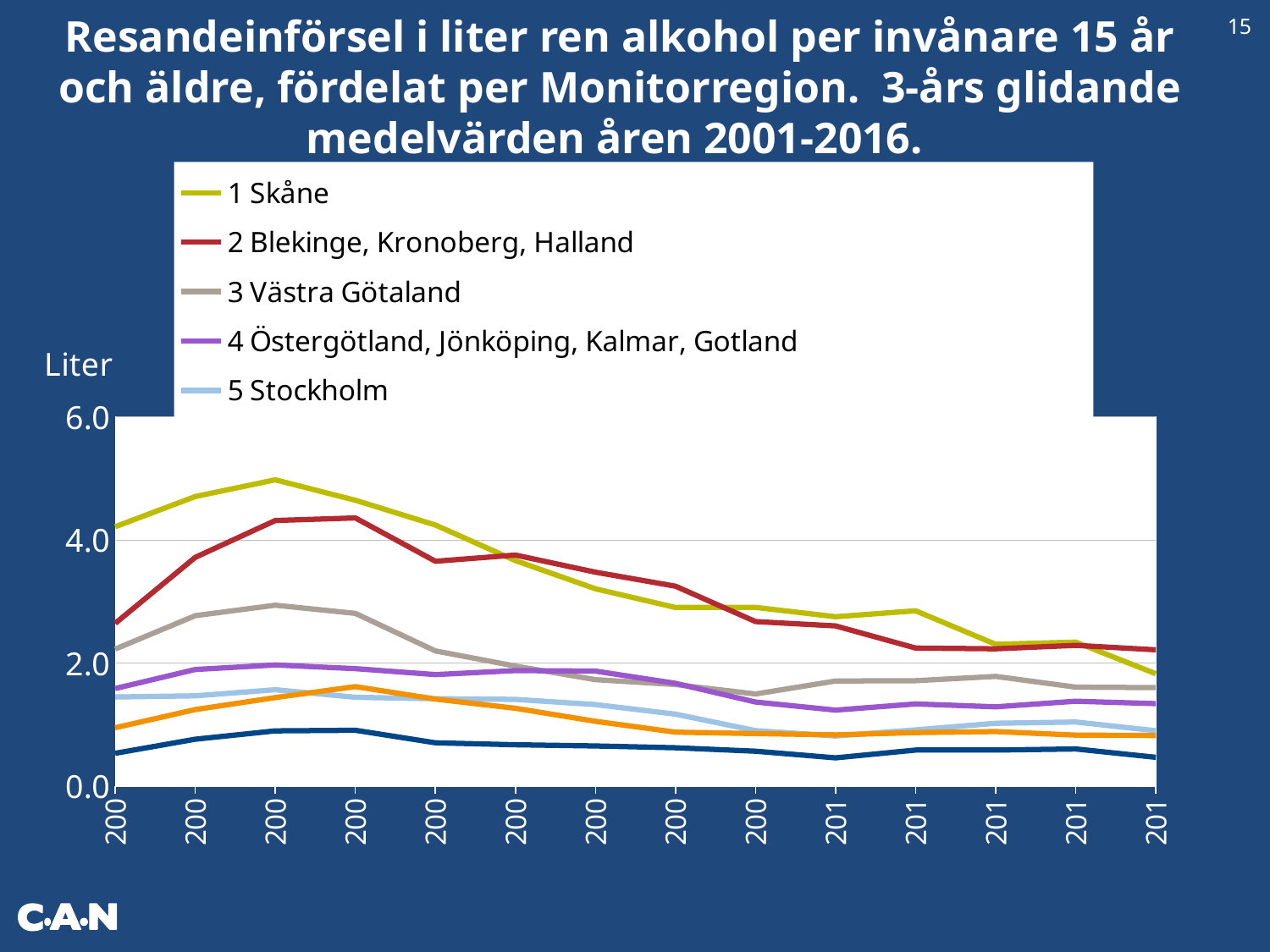
At the first point on the x axis, which is higher: 1 Skåne or 2 Blekinge, Kronoberg, Halland? 1 Skåne Is the highest value of the 5 Stockholm line greater or less than 2.0? less At the last point on the x axis, which is higher: 1 Skåne or 2 Blekinge, Kronoberg, Halland? 2 Blekinge, Kronoberg, Halland Is the highest value of the 1 Skåne line greater or less than 4.0? greater What is the label on the y axis? Liter Which series reaches the highest value anywhere on the chart? 1 Skåne Is the highest value of the 3 Västra Götaland line greater or less than 2.0? greater At the last point on the x axis, which is higher: 3 Västra Götaland or 5 Stockholm? 3 Västra Götaland How many points are plotted along the x axis for each series? 14 What kind of chart is shown on the slide? line chart Overall from the first to the last point, does the 1 Skåne line rise or fall? fall